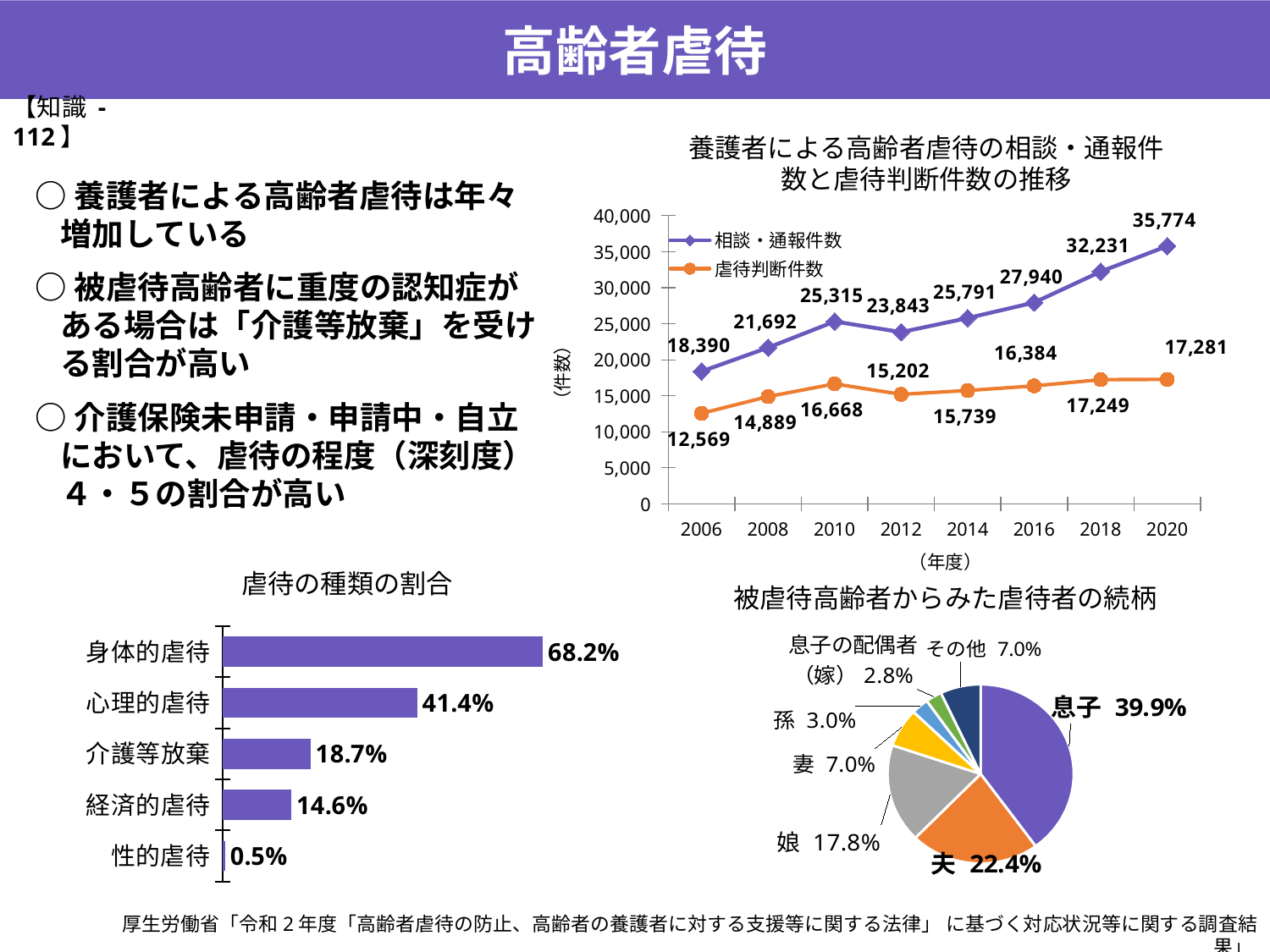
In the line chart titled 養護者による高齢者虐待の相談・通報件数と虐待判断件数の推移, what is the value of 相談・通報件数 in 2020? 35,774 In the pie chart titled 被虐待高齢者からみた虐待者の続柄, which is larger, 娘 or 妻? 娘 In the line chart titled 養護者による高齢者虐待の相談・通報件数と虐待判断件数の推移, does 相談・通報件数 generally rise or fall from 2006 to 2020? rise In the pie chart titled 被虐待高齢者からみた虐待者の続柄, what is the share for 夫? 22.4% What kind of chart is the chart titled 虐待の種類の割合? bar chart In the bar chart titled 虐待の種類の割合, what is the value for 心理的虐待? 41.4% In the line chart titled 養護者による高齢者虐待の相談・通報件数と虐待判断件数の推移, how many series does the legend list? 2 In the line chart titled 養護者による高齢者虐待の相談・通報件数と虐待判断件数の推移, in which year is 虐待判断件数 lowest? 2006 In the line chart titled 養護者による高齢者虐待の相談・通報件数と虐待判断件数の推移, what is the difference between 相談・通報件数 and 虐待判断件数 in 2020? 18,493 In the bar chart titled 虐待の種類の割合, how many categories are shown? 5 In the bar chart titled 虐待の種類の割合, which category has the highest value? 身体的虐待 In the line chart titled 養護者による高齢者虐待の相談・通報件数と虐待判断件数の推移, what is the value of 虐待判断件数 in 2006? 12,569